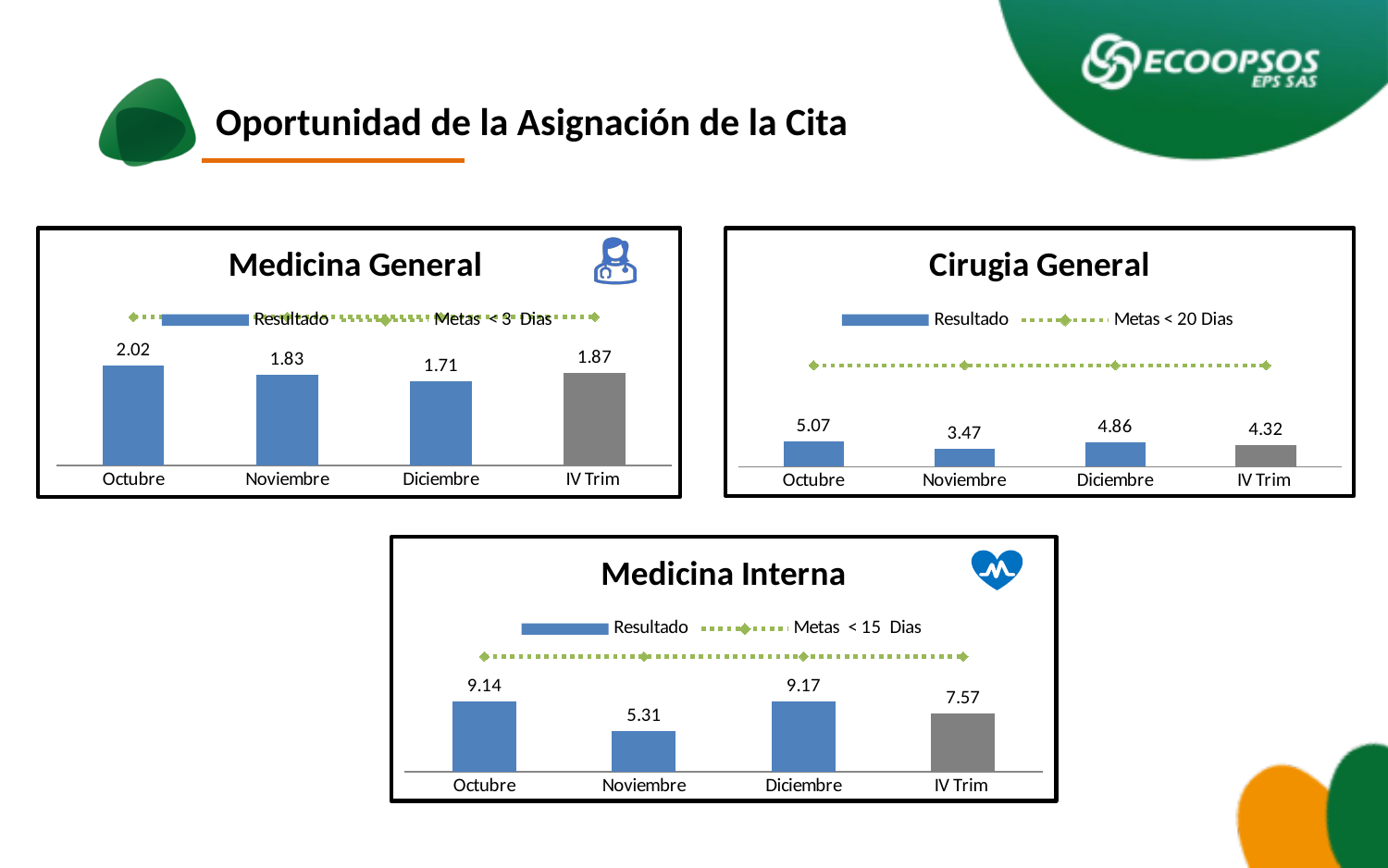
In the Medicina General chart, which month has the lowest Resultado value? Diciembre In the Medicina Interna chart, which category has the lowest Resultado value? Noviembre What kind of chart is the Medicina Interna chart? Combination bar and line chart How many categories are shown on the x axis of the Cirugia General chart? 4 In the Cirugia General chart, which is larger, the value for Diciembre or the value for IV Trim? Diciembre What is the target (Metas) entry in the legend of the Cirugia General chart? Metas < 20 Dias In the Medicina General chart, what is the difference between the Octubre and Diciembre values? 0.31 In the Cirugia General chart, what is the Resultado value for Noviembre? 3.47 In the Medicina General chart, what is the Resultado value for Octubre? 2.02 In the Medicina Interna chart, what is the Resultado value for IV Trim? 7.57 In the Cirugia General chart, which category has the highest Resultado value? Octubre In the Medicina Interna chart, what is the difference between the Diciembre and Noviembre values? 3.86